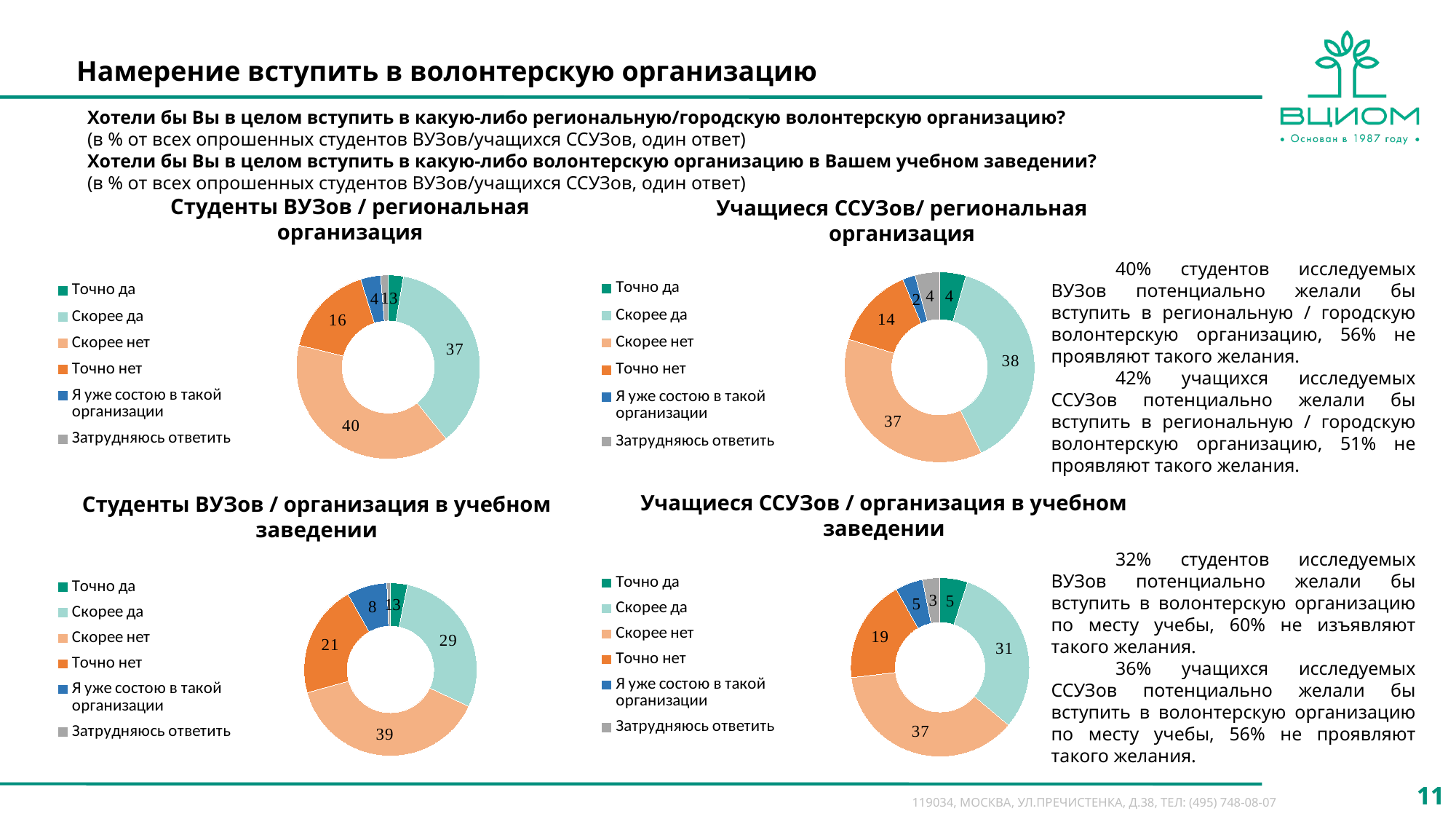
In the chart 'Студенты ВУЗов / региональная организация', what is the value for 'Скорее нет'? 40 In the chart 'Студенты ВУЗов / организация в учебном заведении', what is the difference between 'Скорее нет' and 'Скорее да'? 10 In the chart 'Студенты ВУЗов / организация в учебном заведении', what is the value for 'Я уже состою в такой организации'? 8 In the chart 'Учащиеся ССУЗов / организация в учебном заведении', what is the value for 'Точно да'? 5 In the chart 'Студенты ВУЗов / региональная организация', what is the value for 'Точно нет'? 16 In the chart 'Учащиеся ССУЗов/ региональная организация', what is the value for 'Точно нет'? 14 How many categories does the legend of the chart 'Студенты ВУЗов / региональная организация' list? 6 In the chart 'Учащиеся ССУЗов/ региональная организация', which category has the highest value? Скорее да How many charts are shown on the slide? 4 In the chart 'Учащиеся ССУЗов / организация в учебном заведении', which is larger: 'Точно нет' or 'Скорее да'? Скорее да What kind of chart is 'Учащиеся ССУЗов/ региональная организация'? Donut (pie) chart In the chart 'Учащиеся ССУЗов / организация в учебном заведении', what is the value for 'Скорее нет'? 37